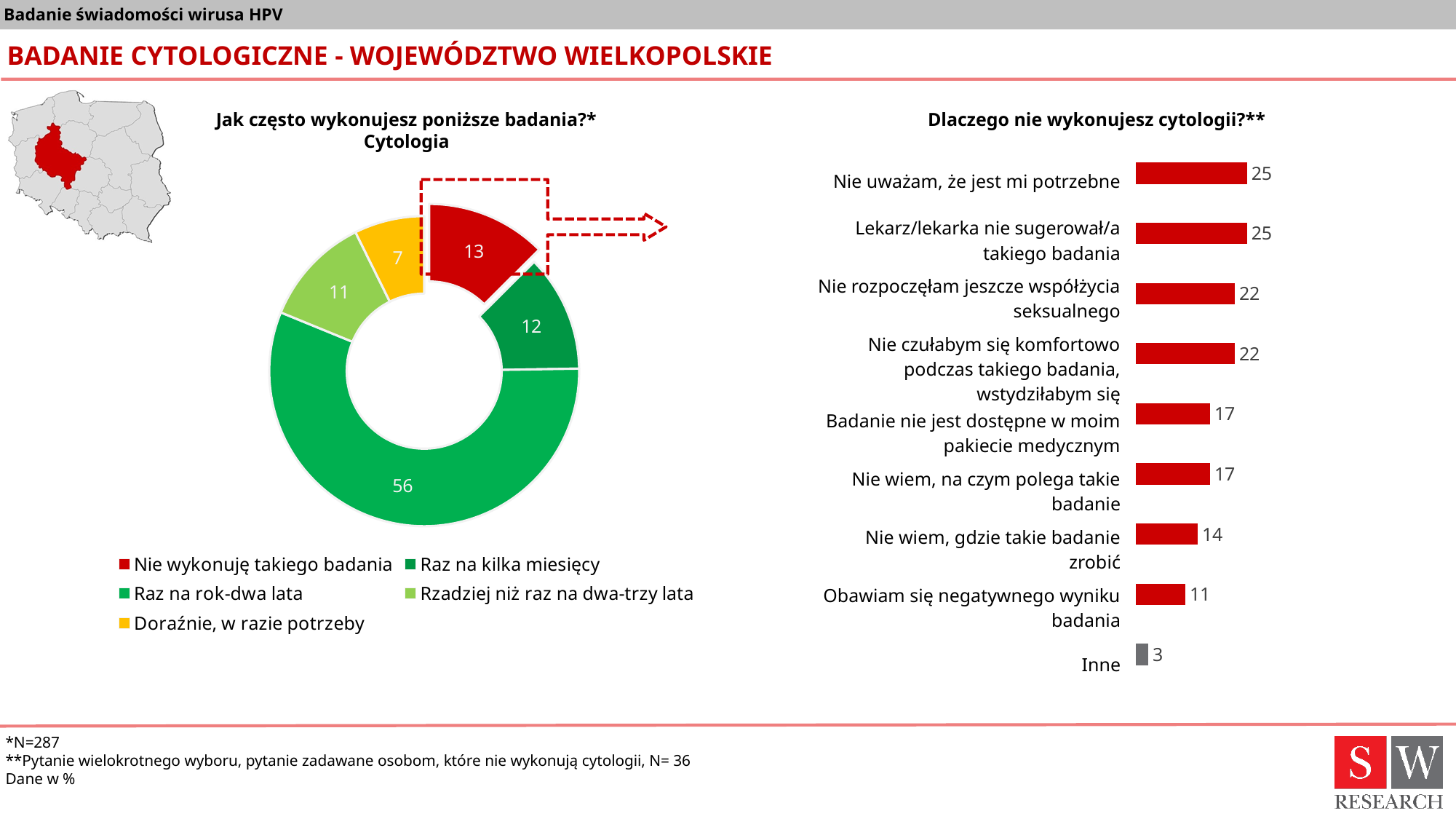
In the chart 'Jak często wykonujesz poniższe badania? Cytologia', what is the value for 'Nie wykonuję takiego badania'? 13 What kind of chart is 'Dlaczego nie wykonujesz cytologii?'? Bar chart In the chart 'Dlaczego nie wykonujesz cytologii?', how many categories are shown? 9 In the chart 'Jak często wykonujesz poniższe badania? Cytologia', how many categories does the legend list? 5 In the chart 'Jak często wykonujesz poniższe badania? Cytologia', which category has the largest value? Raz na rok-dwa lata In the chart 'Dlaczego nie wykonujesz cytologii?', what is the value for 'Inne'? 3 In the chart 'Jak często wykonujesz poniższe badania? Cytologia', which category has the smallest value? Doraźnie, w razie potrzeby What kind of chart is 'Jak często wykonujesz poniższe badania? Cytologia'? Pie (donut) chart In the chart 'Jak często wykonujesz poniższe badania? Cytologia', what is the value for 'Raz na rok-dwa lata'? 56 In the chart 'Dlaczego nie wykonujesz cytologii?', which is larger: 'Nie rozpoczęłam jeszcze współżycia seksualnego' or 'Nie wiem, na czym polega takie badanie'? Nie rozpoczęłam jeszcze współżycia seksualnego In the chart 'Dlaczego nie wykonujesz cytologii?', what is the value for 'Nie wiem, gdzie takie badanie zrobić'? 14 In the chart 'Dlaczego nie wykonujesz cytologii?', what is the difference between 'Nie uważam, że jest mi potrzebne' and 'Obawiam się negatywnego wyniku badania'? 14